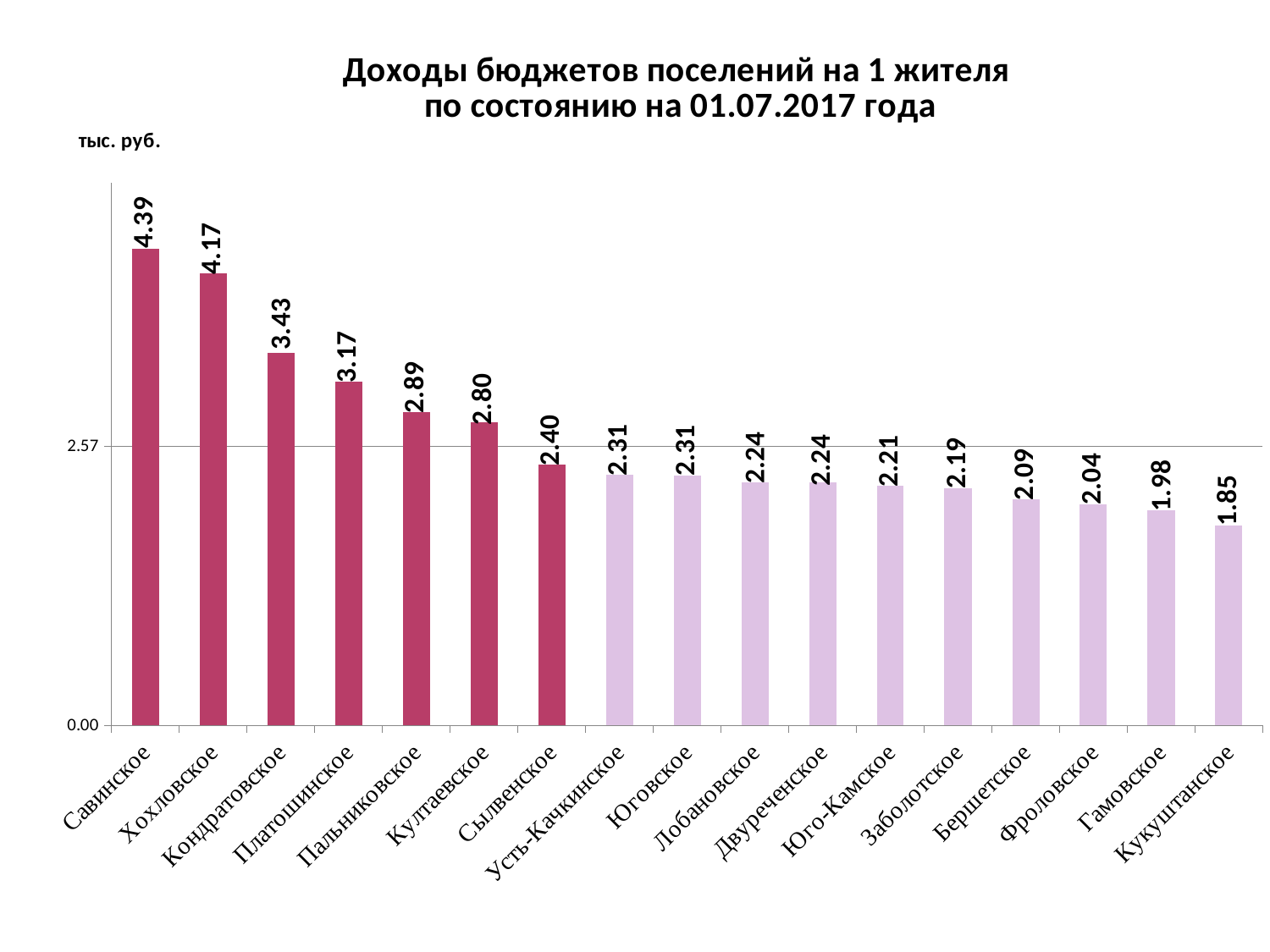
What is the value for Кондратовское? 3.43 Which settlement has the highest value? Савинское What is the value for Кукуштанское? 1.85 Which settlement has the lowest value? Кукуштанское What is the value for Заболотское? 2.19 Do the values rise or fall from left to right along the x axis? fall Which is larger, the value for Платошинское or the value for Пальниковское? Платошинское What unit is shown on the vertical axis label? тыс. руб. How many settlements are shown on the chart? 17 What is the difference between the values for Савинское and Хохловское? 0.22 What is the value for Савинское? 4.39 What kind of chart is this? bar chart